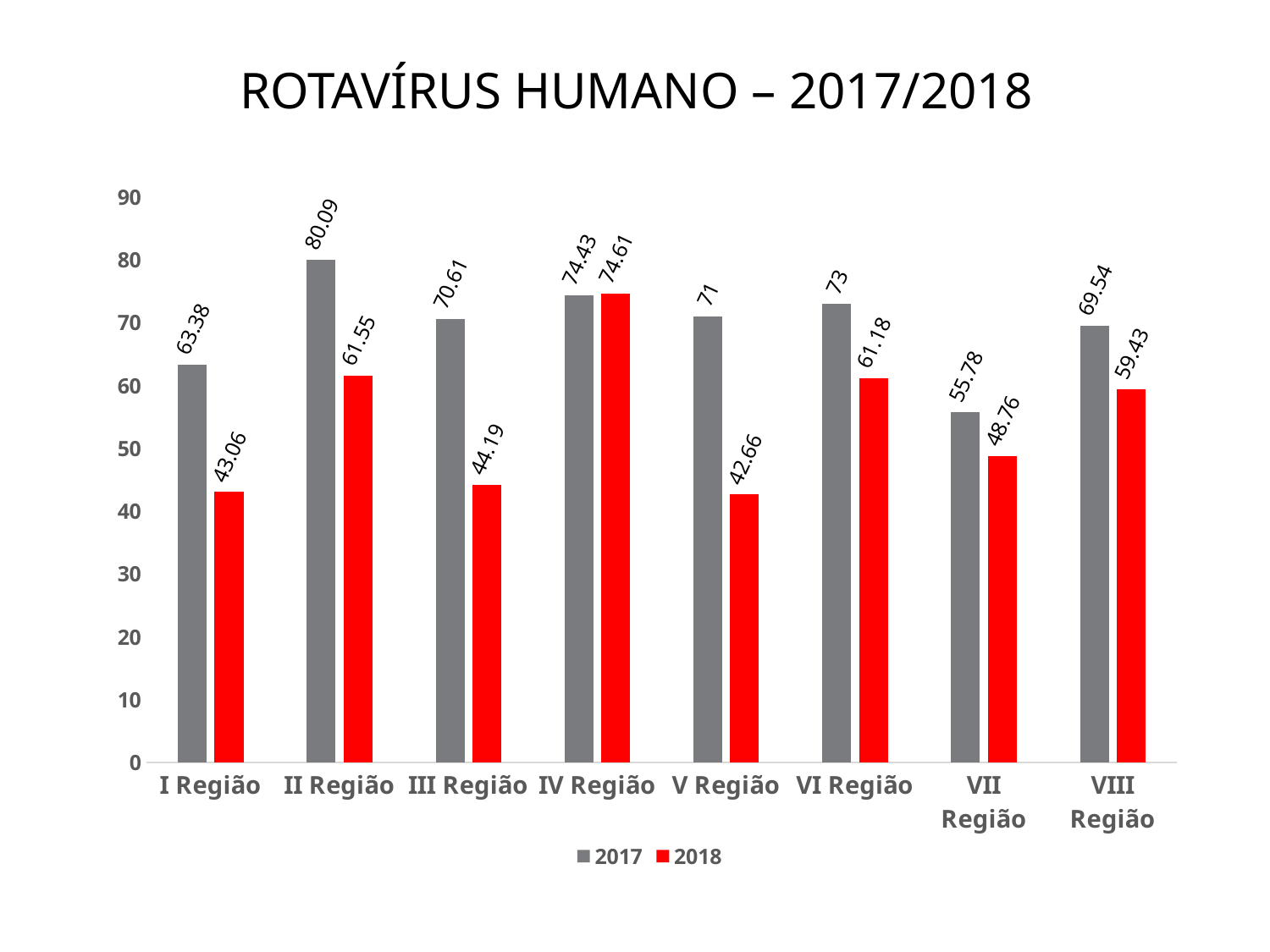
How many series does the legend list? 2 What type of chart is shown on the slide? bar chart What is the 2018 value for VIII Região? 59.43 What is the 2018 value for V Região? 42.66 Which region has the lowest 2017 value? VII Região Is the 2018 value for VII Região greater or less than 50? less For VI Região, which series has the larger value, 2017 or 2018? 2017 What is the 2017 value for II Região? 80.09 What is the difference between the 2017 and 2018 values for I Região? 20.32 How many regions are shown on the x axis? 8 Which region has the lowest 2018 value? V Região Which region has the highest 2017 value? II Região